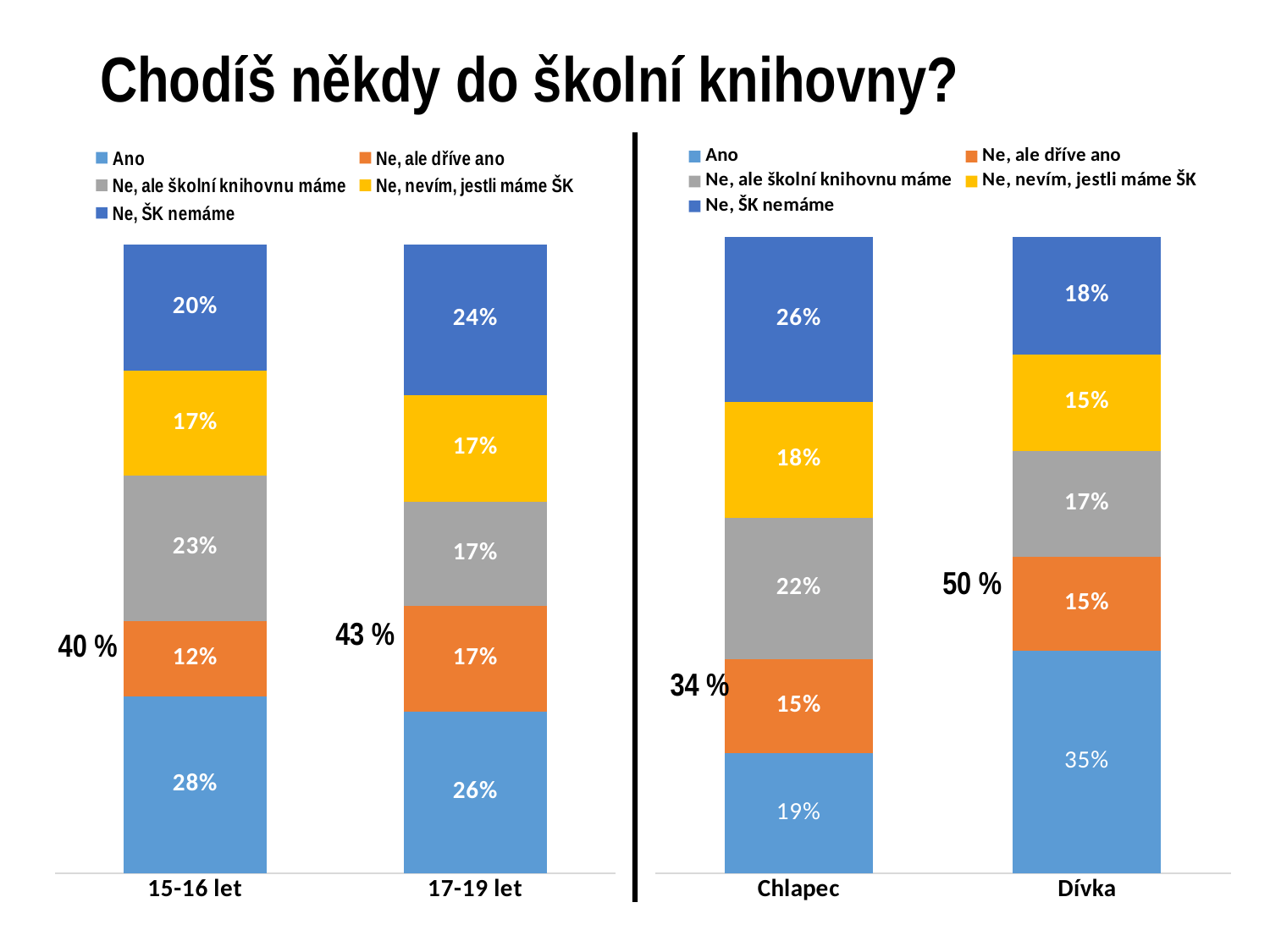
How many categories are shown on the x axis of the right chart? 2 In the right chart, which segment is the smallest in the Chlapec bar? Ne, ale dříve ano In the right chart, what is the difference between the 'Ne, ŠK nemáme' values for Chlapec and Dívka? 8% In the right chart, what is the value of 'Ano' for Dívka? 35% In the right chart, what is the value of 'Ne, ale školní knihovnu máme' for Chlapec? 22% In the right chart, which category has the higher 'Ano' value, Chlapec or Dívka? Dívka How many series does the legend of the left chart list? 5 In the left chart, which segment is the largest in the 15-16 let bar? Ano In the left chart, what is the value of 'Ne, ŠK nemáme' for 17-19 let? 24% What type of chart is the left chart? Stacked bar chart In the left chart, what is the difference between the 'Ne, ale dříve ano' values for 17-19 let and 15-16 let? 5% In the left chart, what is the value of 'Ano' for 15-16 let? 28%